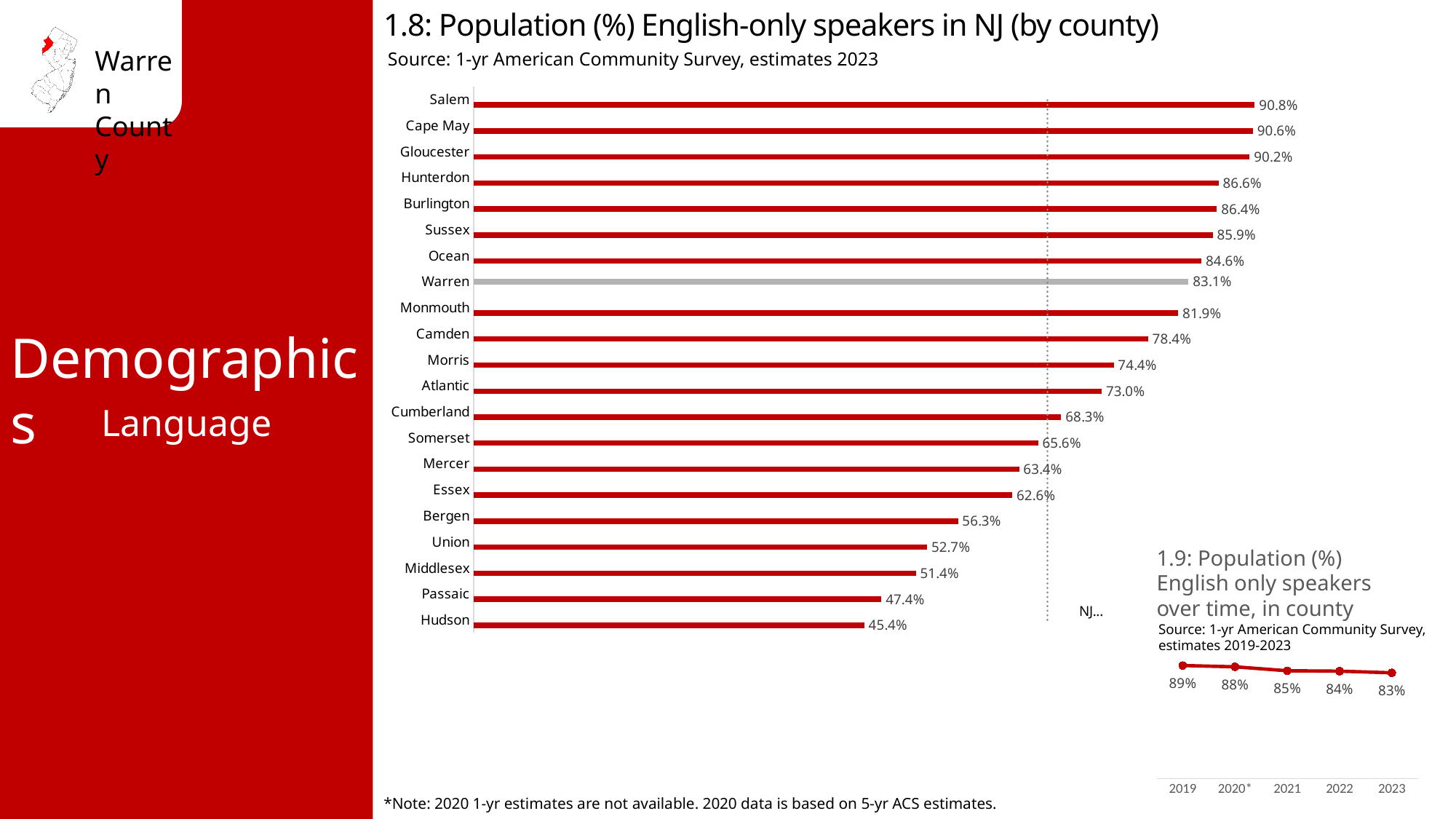
In chart 1.8, which county has the highest percentage of English-only speakers? Salem In chart 1.9, do the values rise or fall from 2019 to 2023? Fall In chart 1.8, how many counties are shown? 21 In chart 1.8, what is the value for Passaic? 47.4% What kind of chart is chart 1.8? Bar chart In chart 1.8, which county has the lowest percentage of English-only speakers? Hudson In chart 1.9, what is the difference between the 2019 and 2023 values? 6% In chart 1.8, which has a higher value, Morris or Atlantic? Morris In chart 1.8 (Population (%) English-only speakers in NJ by county), what is the value for Warren? 83.1% In chart 1.8, what is the value for Monmouth? 81.9% In chart 1.8, what is the difference between the values for Salem and Hudson? 45.4% In chart 1.9 (Population (%) English only speakers over time, in county), what is the value for 2019? 89%